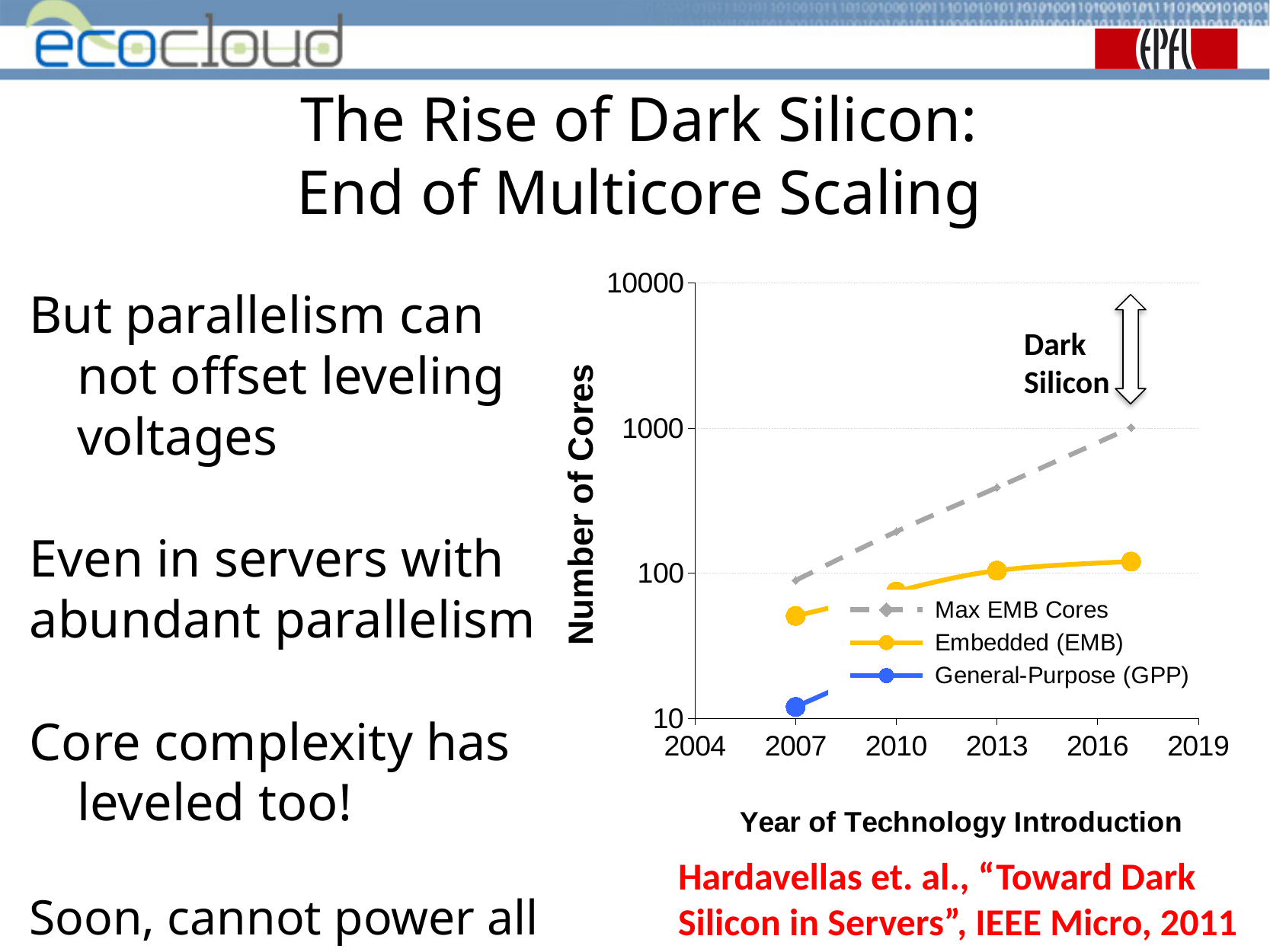
What kind of chart is shown on the slide? line chart Is the value for Max EMB Cores in 2013 greater or less than 100? greater Is the value for General-Purpose (GPP) in 2007 greater or less than 100? less Does the Max EMB Cores series rise or fall as the year increases? rise How many year tick labels are shown on the horizontal axis? 6 Is the value for Max EMB Cores in 2013 greater or less than 1000? less In 2013, which series has the larger value: Max EMB Cores or Embedded (EMB)? Max EMB Cores What is the label of the chart's vertical axis? Number of Cores How many series does the chart's legend list? 3 In 2007, which series has the larger value: Embedded (EMB) or General-Purpose (GPP)? Embedded (EMB) What is the label of the chart's horizontal axis? Year of Technology Introduction